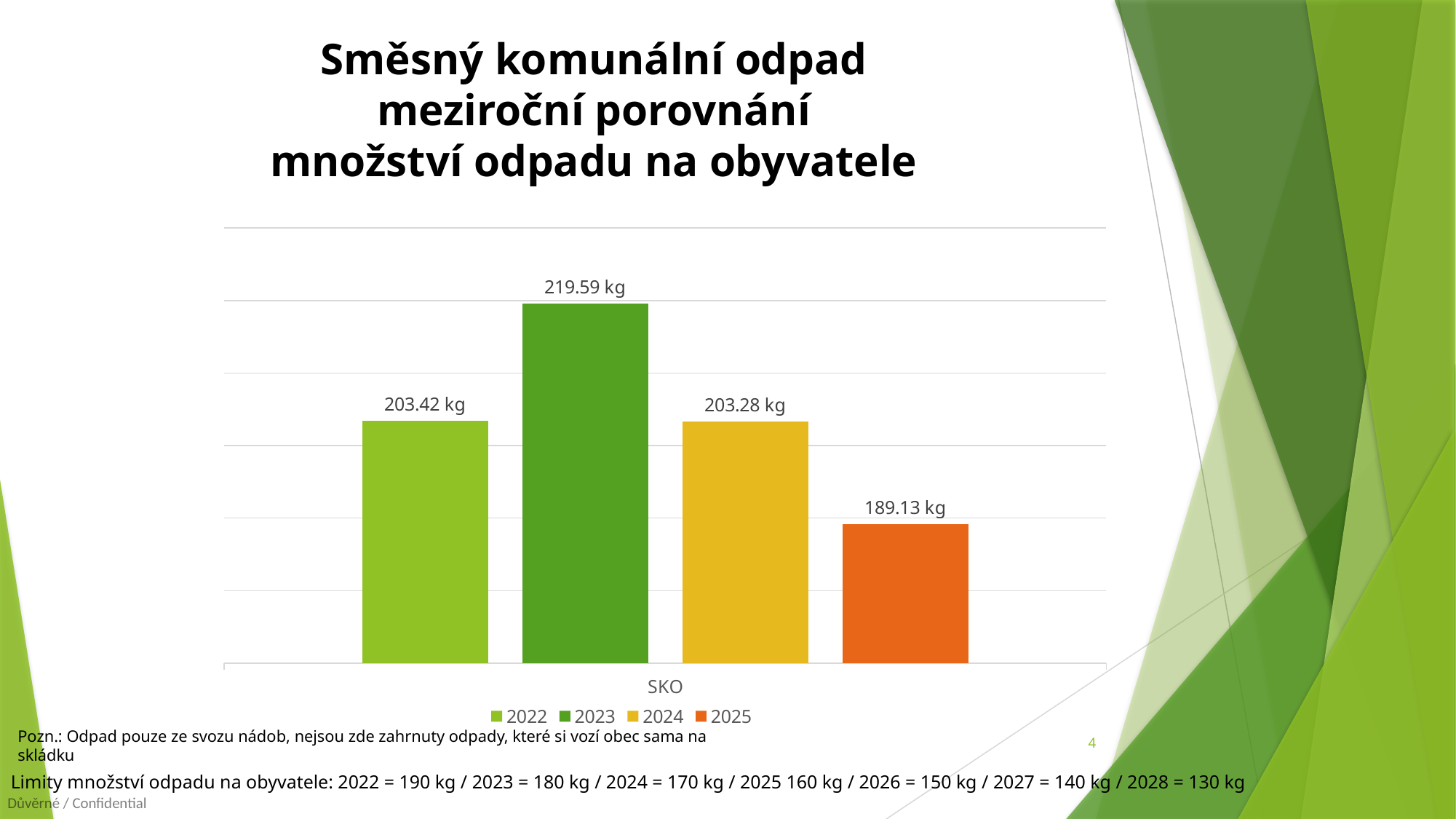
What is the value for 2025 in the chart? 189.13 kg What is the difference between the 2023 value and the 2022 value? 16.17 kg Which year has the highest value in the chart? 2023 Which is larger, the value for 2022 or the value for 2025? 2022 How many series does the legend list? 4 Which year has the lowest value in the chart? 2025 What kind of chart is shown on the slide? Bar chart What is the value for 2022 in the chart? 203.42 kg What is the value for 2023 in the chart? 219.59 kg What is the value for 2024 in the chart? 203.28 kg What is the label on the category axis of the chart? SKO What is the difference between the 2023 value and the 2025 value? 30.46 kg